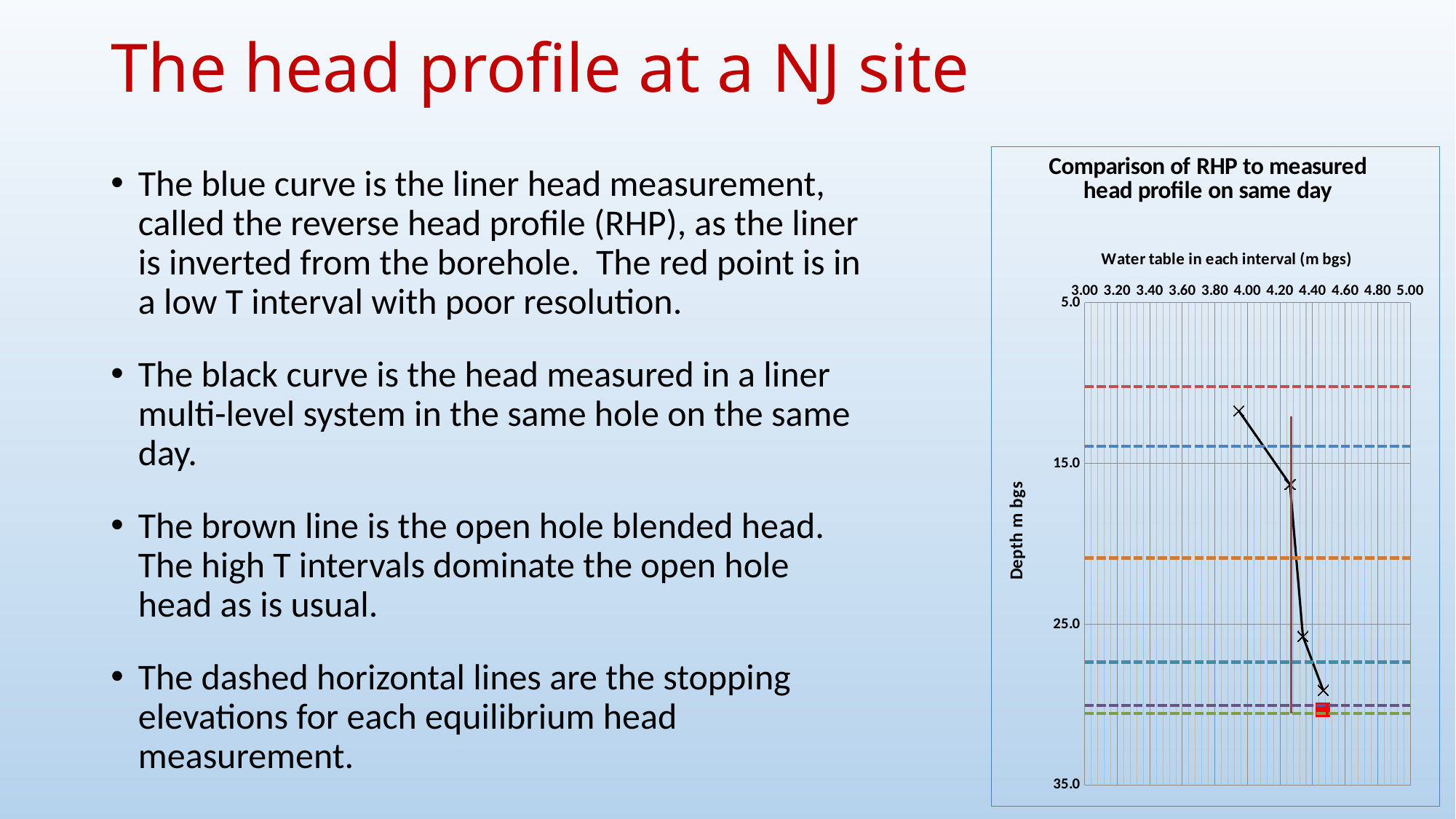
What is the largest depth value shown on the vertical axis of the chart? 35.0 What is the largest value shown on the horizontal axis of the chart? 5.00 What is the title of the chart on the slide? Comparison of RHP to measured head profile on same day As depth increases along the black curve, does the water table value increase or decrease? increase Which point on the black curve has the smallest water table value, the shallowest or the deepest? the shallowest How many x-marked points are plotted on the black curve? 4 Is the water table value of the shallowest point on the black curve greater or less than 3.80? greater Is the depth of the red square point greater or less than 25.0 m bgs? greater Is the depth of the shallowest point on the black curve greater or less than 15.0 m bgs? less What is the label of the horizontal axis of the chart? Water table in each interval (m bgs) What kind of chart is shown on the slide? line chart